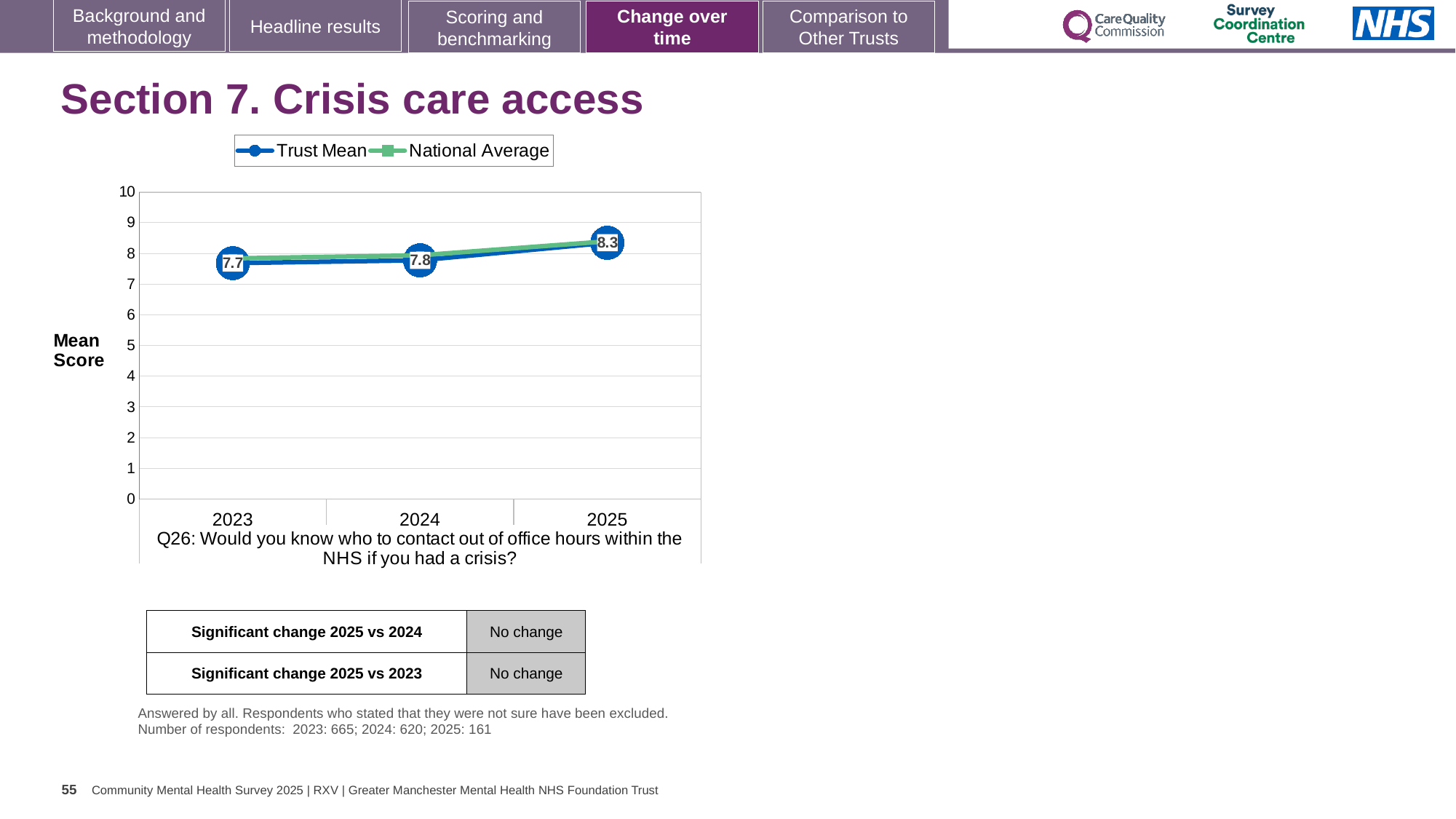
What kind of chart is shown on the slide? Line chart What is the difference between the Trust Mean in 2025 and in 2023? 0.6 What is the Trust Mean value for 2024? 7.8 How many series does the legend list? 2 In which year is the Trust Mean lowest? 2023 In which year is the Trust Mean highest? 2025 Is the Trust Mean higher in 2025 or in 2024? 2025 What is the Trust Mean value for 2025? 8.3 What is the Trust Mean value for 2023? 7.7 Does the Trust Mean rise or fall from 2023 to 2025? Rise How many years are shown on the x axis? 3 Is the National Average value for 2025 greater or less than 7? greater